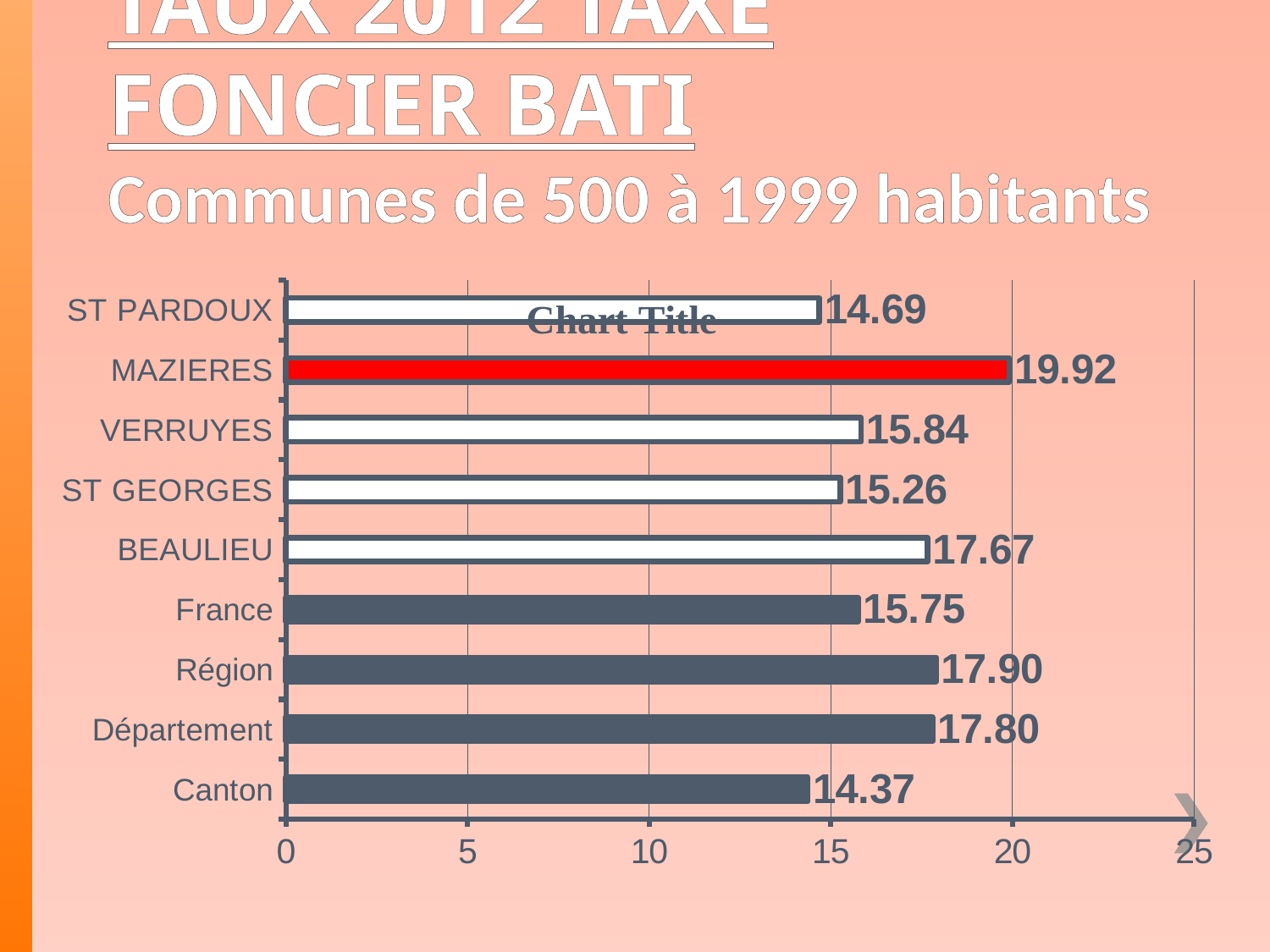
Which is larger, the value for Région or the value for Département? Région What is the value for MAZIERES? 19.92 Which category has the highest value? MAZIERES Is the value for VERRUYES greater or less than 15? greater What is the value for BEAULIEU? 17.67 How many categories are shown on the chart? 9 Which bar is coloured red? MAZIERES What is the difference between the values for MAZIERES and ST PARDOUX? 5.23 What is the value for Canton? 14.37 What is the difference between the values for France and ST GEORGES? 0.49 What kind of chart is shown on the slide? bar chart Which category has the lowest value? Canton